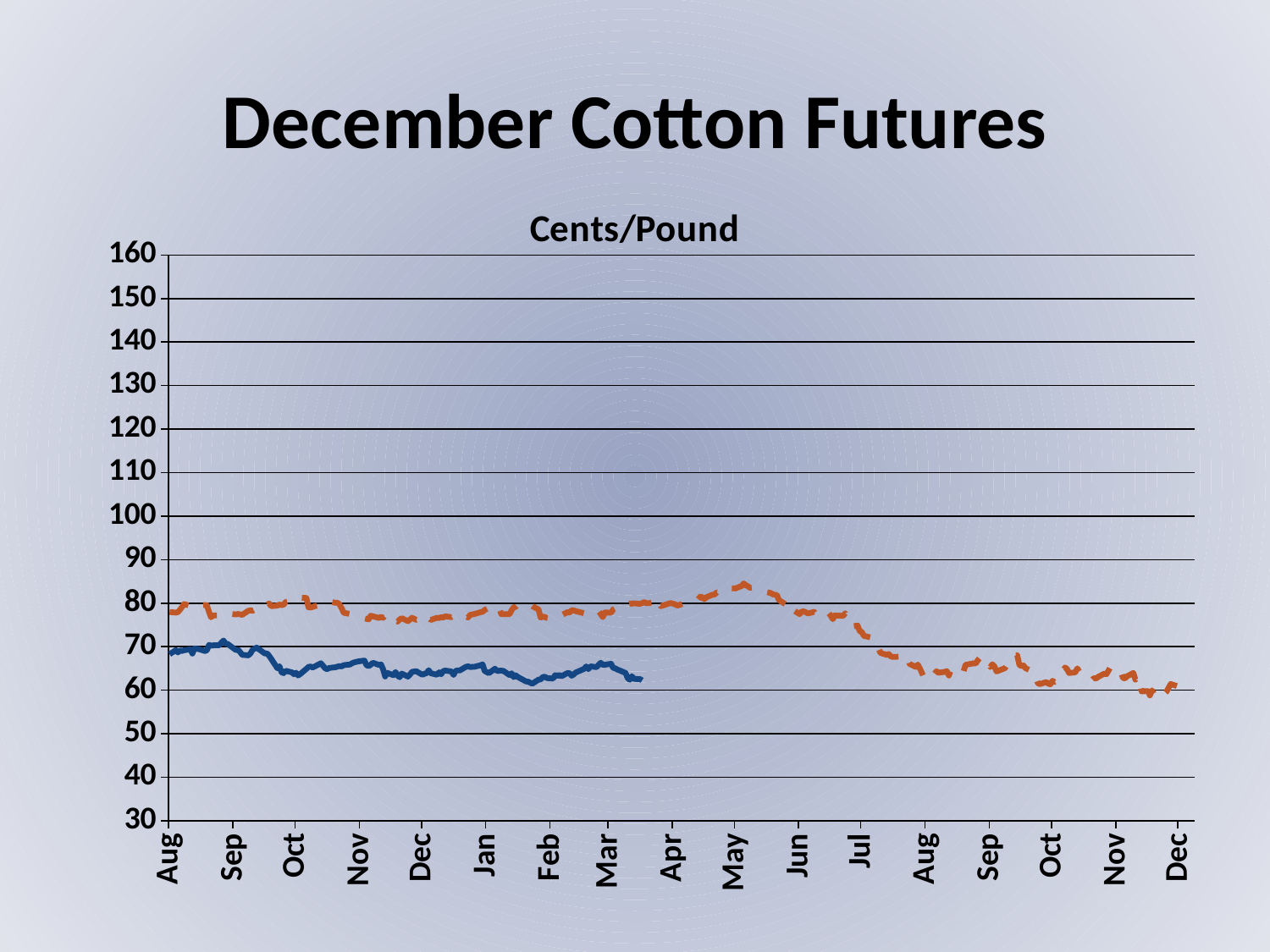
What kind of chart is shown on the slide? line chart What is the highest value shown on the y axis? 160 Around the first Sep, which line is higher, the orange dashed line or the blue solid line? orange dashed line Is the value of the orange dashed line at the first Aug greater or less than 70? greater Is the value of the blue solid line around Feb greater or less than 70? less Around which month does the orange dashed line reach its highest value? May How many lines are plotted on the chart? 2 What is the title shown above the chart's plot area? Cents/Pound Is the value of the orange dashed line at the final Dec greater or less than 70? less Does the orange dashed line rise or fall from May to the final Dec? fall How many month labels are shown along the x axis? 17